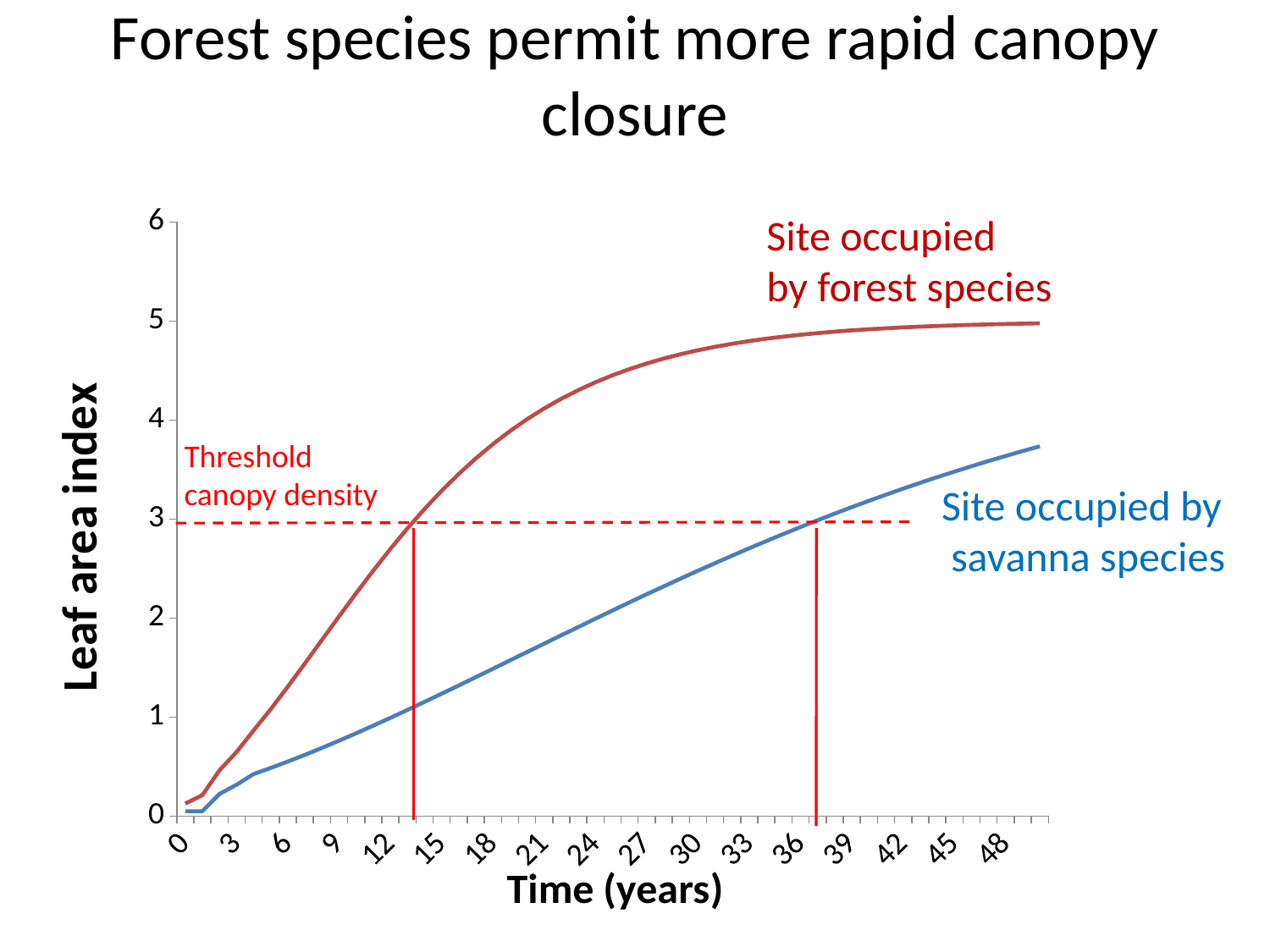
Does the leaf area index for the site occupied by savanna species rise or fall over time? Rise Is the leaf area index for the site occupied by savanna species at year 48 greater or less than 3? greater Which series reaches the threshold canopy density first? Site occupied by forest species Is the leaf area index for the site occupied by forest species at year 12 greater or less than 3? less At year 24, which site has the higher leaf area index: the one occupied by forest species or the one occupied by savanna species? Site occupied by forest species What kind of chart is shown on the slide? Line chart How many series are plotted on the chart? 2 What is the title of the chart on the slide? Forest species permit more rapid canopy closure What is the label of the y axis? Leaf area index Is the leaf area index for the site occupied by forest species at year 24 greater or less than 4? greater Does the leaf area index for the site occupied by forest species rise or fall over time? Rise